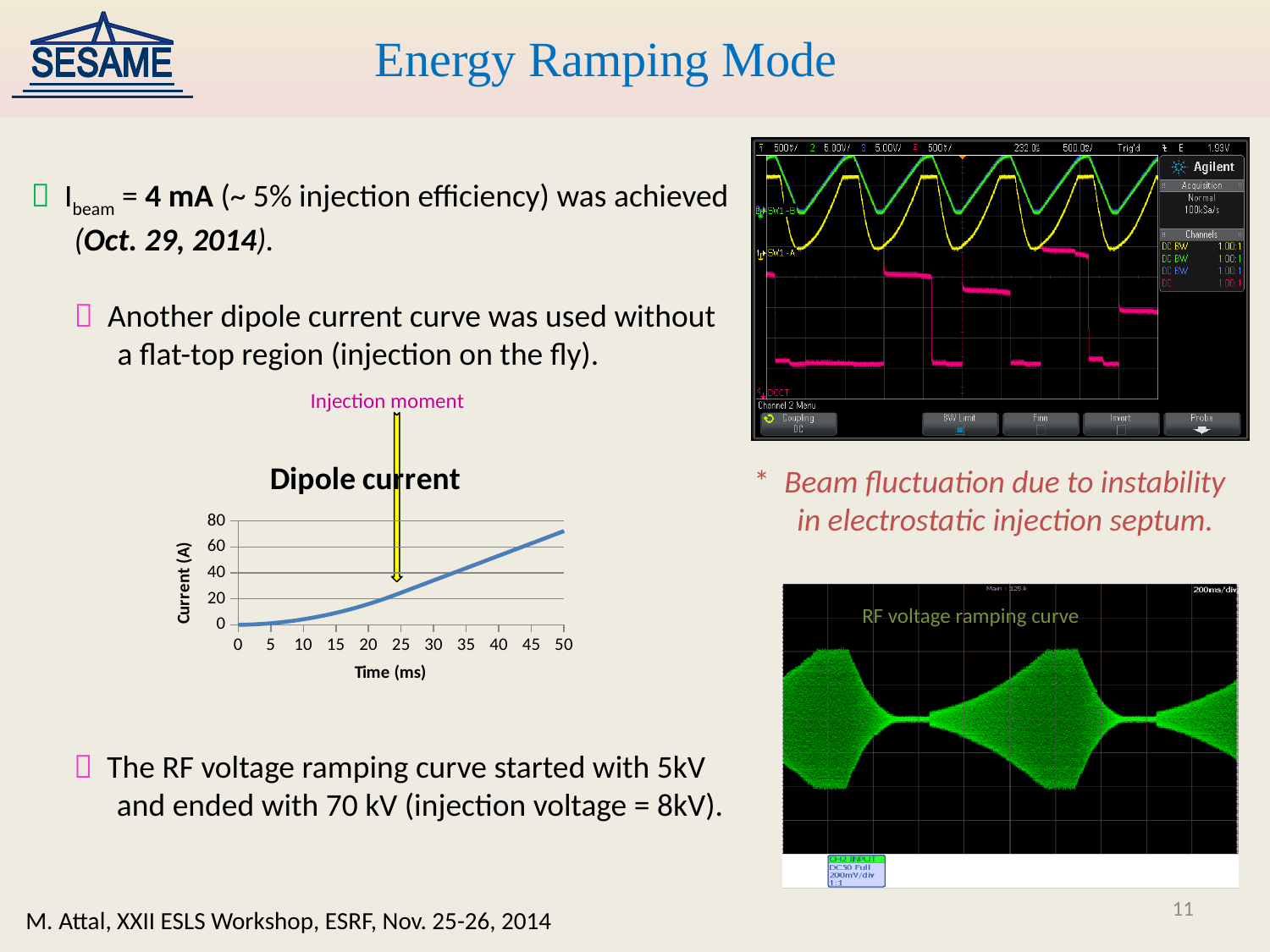
In the "Dipole current" chart, at which time on the x axis is the current highest? 50 What is the label of the y axis in the "Dipole current" chart? Current (A) In the "Dipole current" chart, at which time on the x axis is the current lowest? 0 In the "Dipole current" chart, is the value at 50 ms greater or less than 60? greater In the "Dipole current" chart, is the value at 25 ms greater or less than 40? less In the "Dipole current" chart, which time has the higher current, 20 ms or 45 ms? 45 ms What is the title of the line chart on the slide? Dipole current What kind of chart is the "Dipole current" chart? line chart In the "Dipole current" chart, at what time does the "Injection moment" arrow point? 25 ms In the "Dipole current" chart, is the value at 10 ms greater or less than 20? less In the "Dipole current" chart, does the current rise or fall as time increases? rise